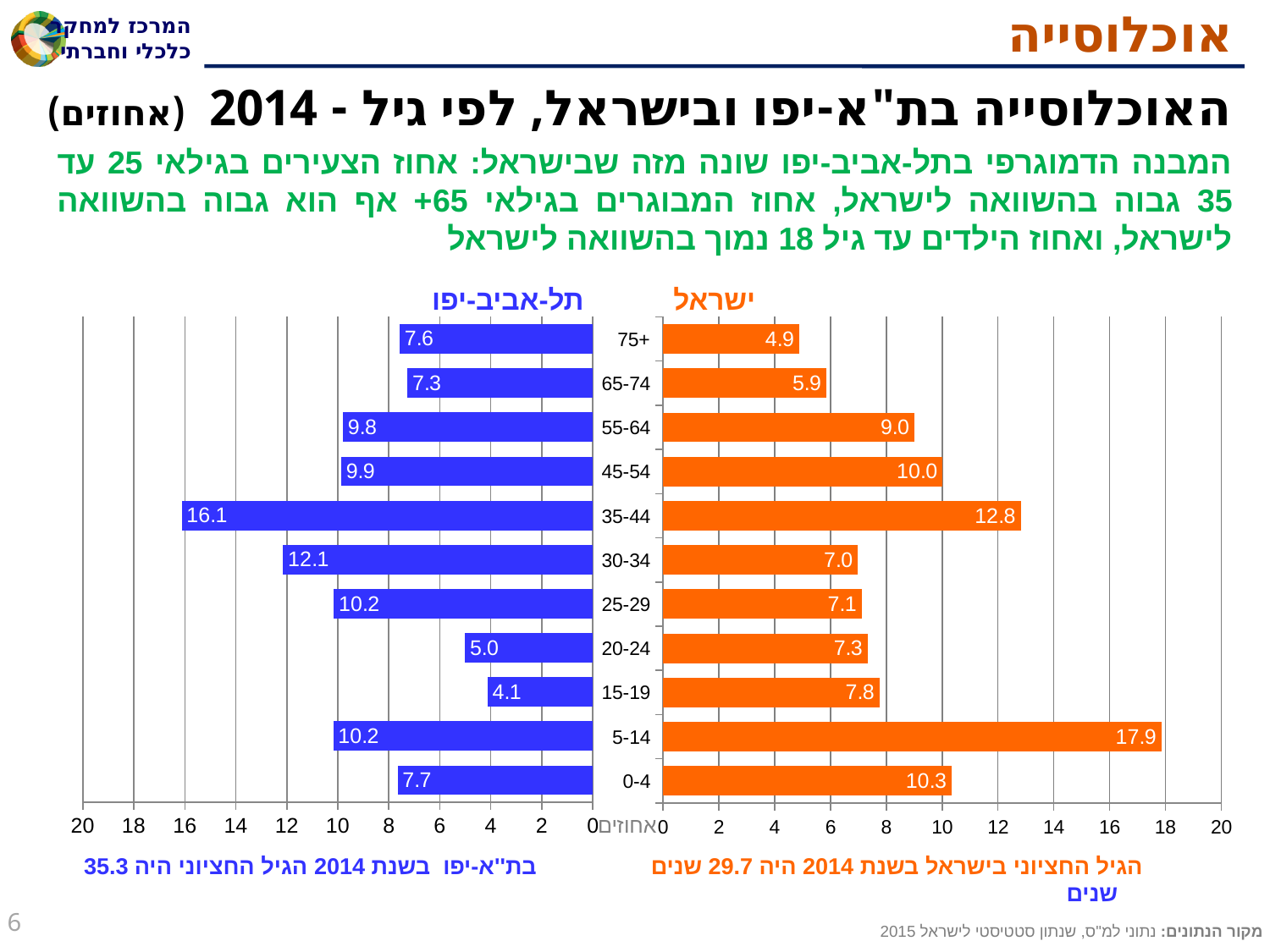
For the 5-14 age group, which series has the larger value, Tel Aviv-Yafo or Israel? Israel What is the value for the 35-44 age group in the Tel Aviv-Yafo (תל-אביב-יפו) series? 16.1 How many series does the chart show? 2 What is the difference between the Tel Aviv-Yafo and Israel values for the 35-44 age group? 3.3 What is the value for the 75+ age group in the Israel (ישראל) series? 4.9 Which age group has the highest value in the Tel Aviv-Yafo (תל-אביב-יפו) series? 35-44 What is the value for the 5-14 age group in the Israel (ישראל) series? 17.9 What type of chart is shown on the slide? Bar chart Which age group has the highest value in the Israel (ישראל) series? 5-14 Which age group has the lowest value in the Tel Aviv-Yafo (תל-אביב-יפו) series? 15-19 How many age groups are shown in the chart? 11 Which age group has the lowest value in the Israel (ישראל) series? 75+